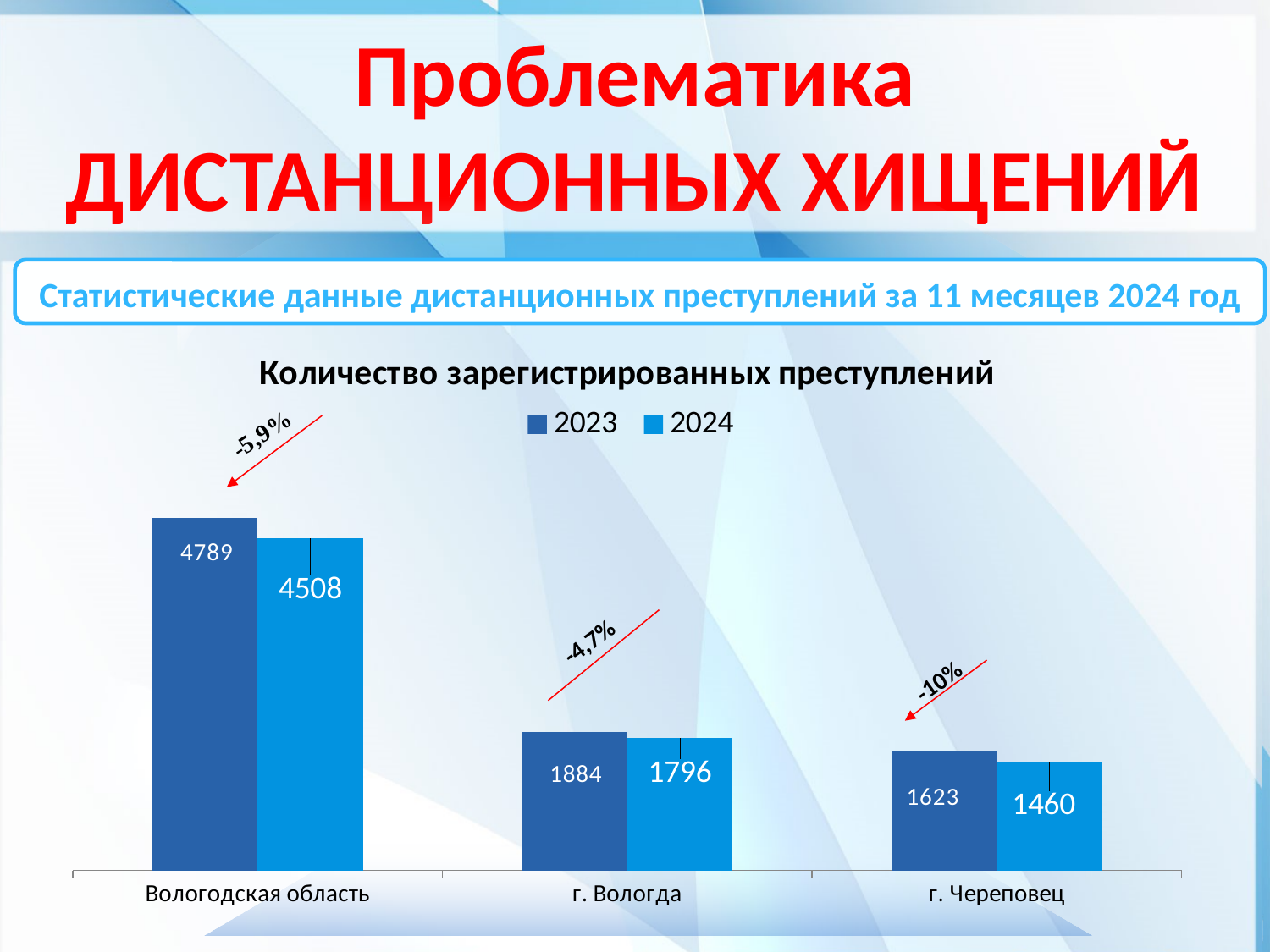
What is the value for Вологодская область in 2023? 4789 What is the value for г. Вологда in 2024? 1796 What is the difference between the 2023 and 2024 values for Вологодская область? 281 How many series does the legend list? 2 How many categories are shown on the x axis? 3 What is the value for г. Череповец in 2024? 1460 What is the difference between the 2023 and 2024 values for г. Вологда? 88 What is the title of the chart? Количество зарегистрированных преступлений Which category has the highest value in the 2023 series? Вологодская область What kind of chart is shown on the slide? bar chart Which is larger: the 2023 value for г. Вологда or the 2023 value for г. Череповец? г. Вологда Which category has the lowest value in the 2024 series? г. Череповец